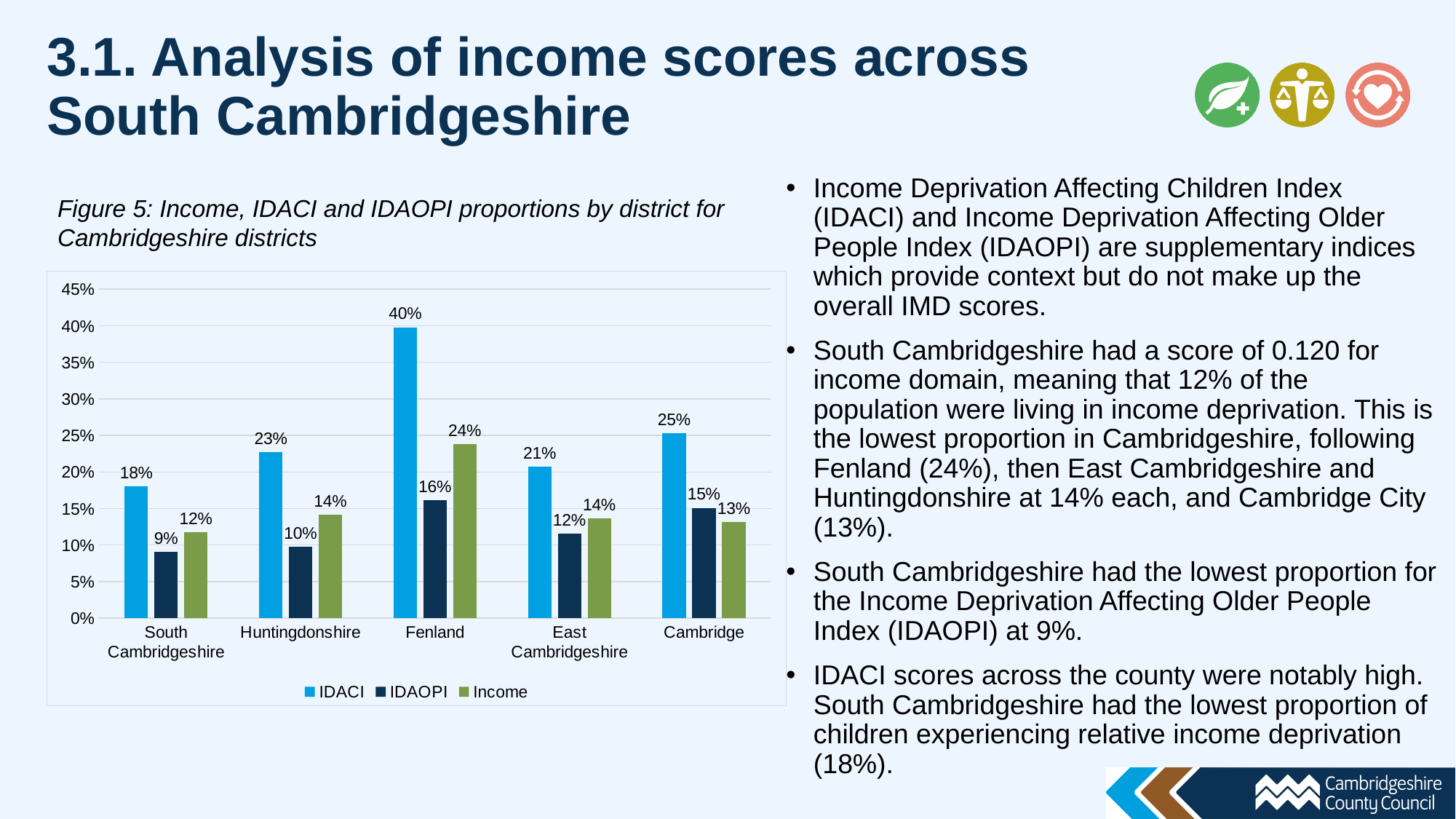
Which district has the highest IDACI value? Fenland How many districts are shown on the x axis? 5 Is the IDACI value for Huntingdonshire greater or less than 20%? greater Which is larger, the IDAOPI value for Fenland or the IDAOPI value for Cambridge? Fenland What is the figure caption above the chart? Figure 5: Income, IDACI and IDAOPI proportions by district for Cambridgeshire districts What kind of chart is shown? bar chart How many series does the legend list? 3 Which district has the lowest Income value? South Cambridgeshire What is the IDACI value for Fenland? 40% What is the Income value for Huntingdonshire? 14% What is the IDAOPI value for South Cambridgeshire? 9% What is the difference between the IDACI values for Fenland and Cambridge? 15%